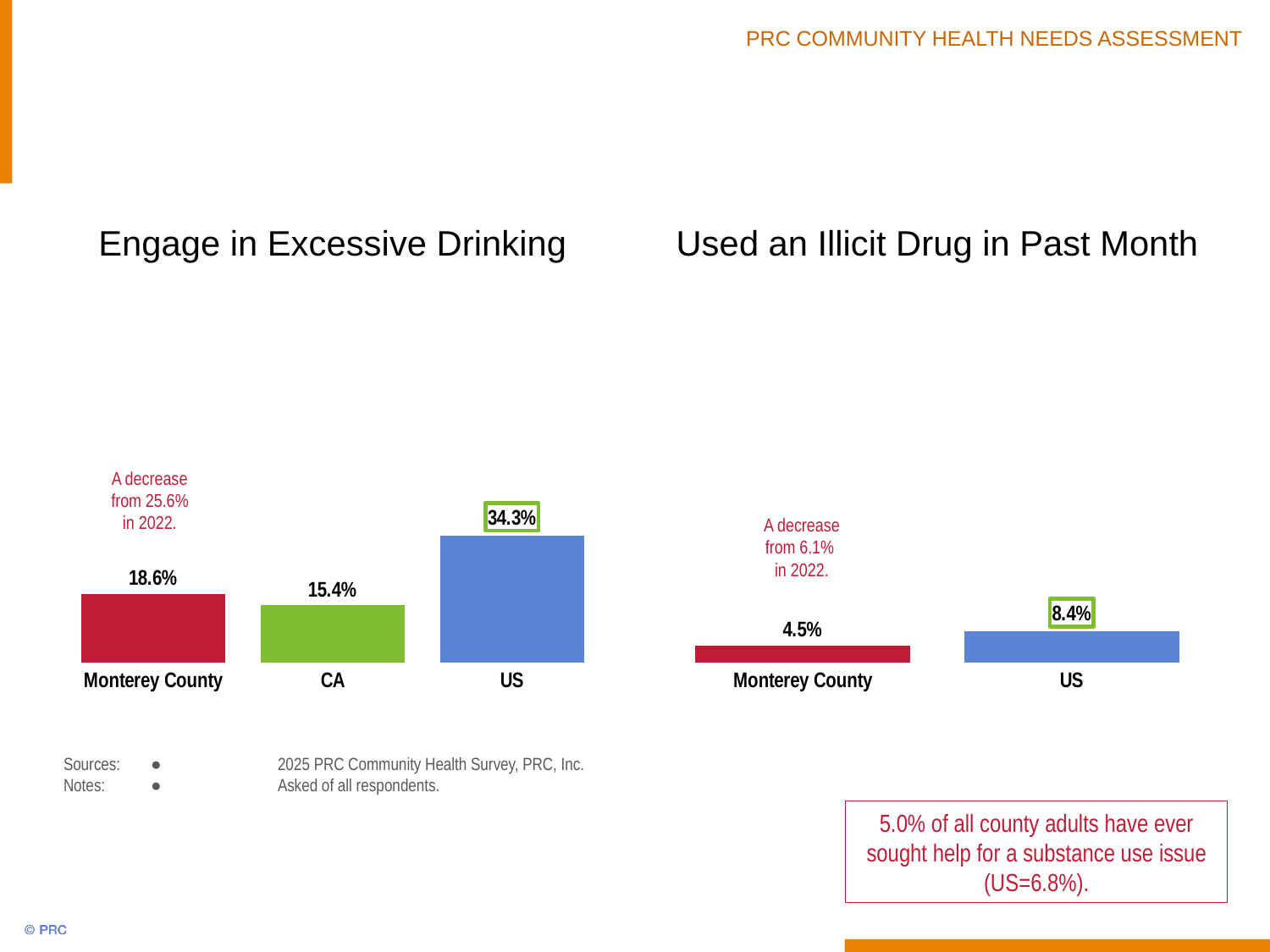
What kind of chart is the 'Used an Illicit Drug in Past Month' chart? Bar chart In the 'Engage in Excessive Drinking' chart, what is the difference between the US value and the Monterey County value? 15.7% In the 'Engage in Excessive Drinking' chart, what is the value for CA? 15.4% In the 'Engage in Excessive Drinking' chart, which category has the lowest value? CA In the 'Used an Illicit Drug in Past Month' chart, what is the value for US? 8.4% In the 'Used an Illicit Drug in Past Month' chart, what is the value for Monterey County? 4.5% In the 'Engage in Excessive Drinking' chart, what is the value for Monterey County? 18.6% In the 'Engage in Excessive Drinking' chart, which category has the highest value? US In the 'Engage in Excessive Drinking' chart, how many categories are shown? 3 In the 'Engage in Excessive Drinking' chart, what was the Monterey County value in 2022 according to the annotation? 25.6% In the 'Used an Illicit Drug in Past Month' chart, what is the difference between the US value and the Monterey County value? 3.9% In the 'Used an Illicit Drug in Past Month' chart, which is larger, the Monterey County value or the US value? US